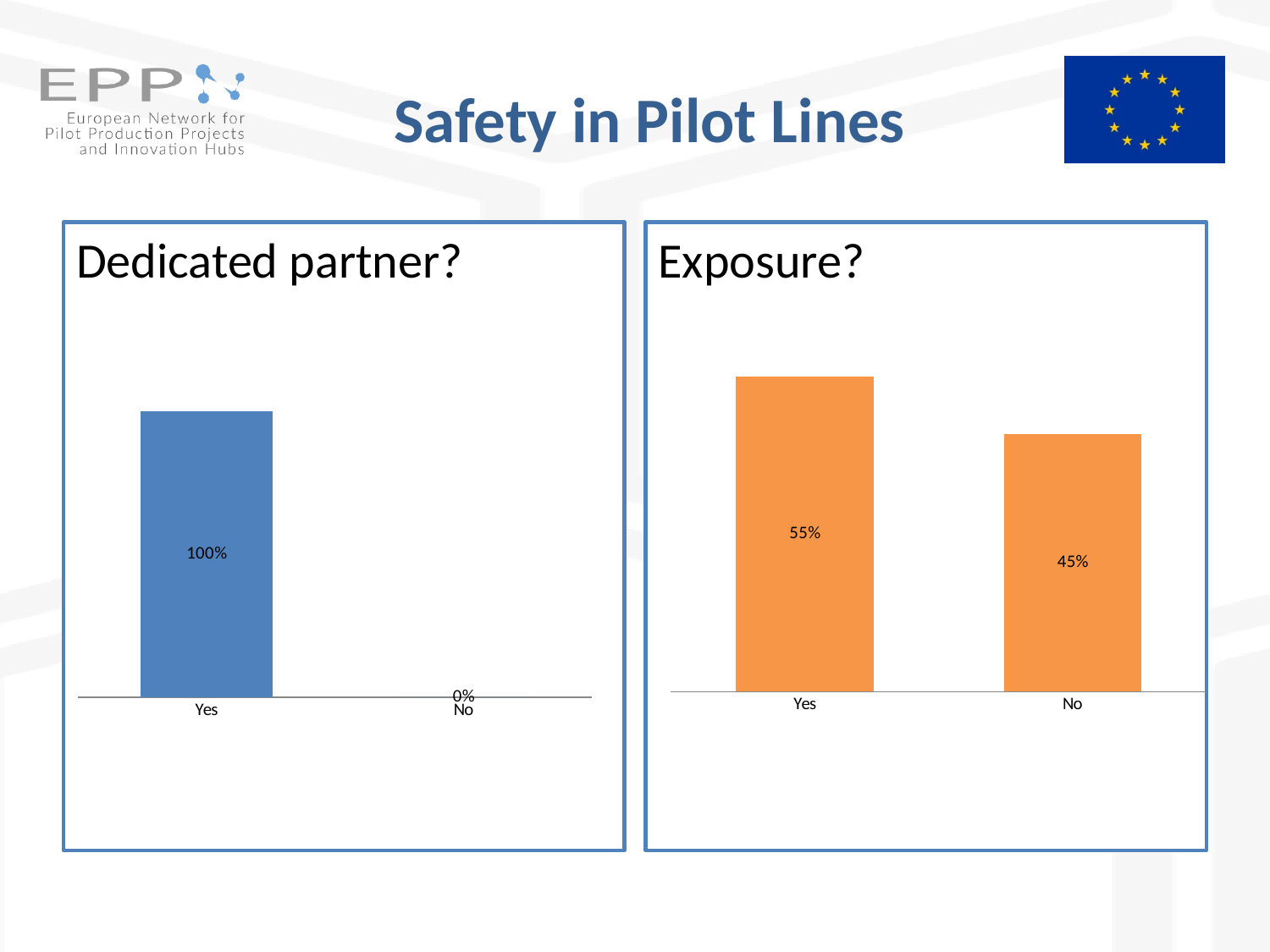
In the 'Exposure?' chart, what is the value for No? 45% In the 'Exposure?' chart, which category has the highest value? Yes What kind of chart is the 'Dedicated partner?' chart? Bar chart In the 'Dedicated partner?' chart, what is the value for No? 0% In the 'Exposure?' chart, what is the value for Yes? 55% In the 'Exposure?' chart, which is larger, the value for Yes or the value for No? Yes In the 'Dedicated partner?' chart, what is the value for Yes? 100% How many categories are shown in the 'Exposure?' chart? 2 In the 'Exposure?' chart, what is the difference between the values for Yes and No? 10% In the 'Dedicated partner?' chart, what is the difference between the values for Yes and No? 100% What colour are the bars in the 'Exposure?' chart? Orange In the 'Dedicated partner?' chart, which category has the lowest value? No